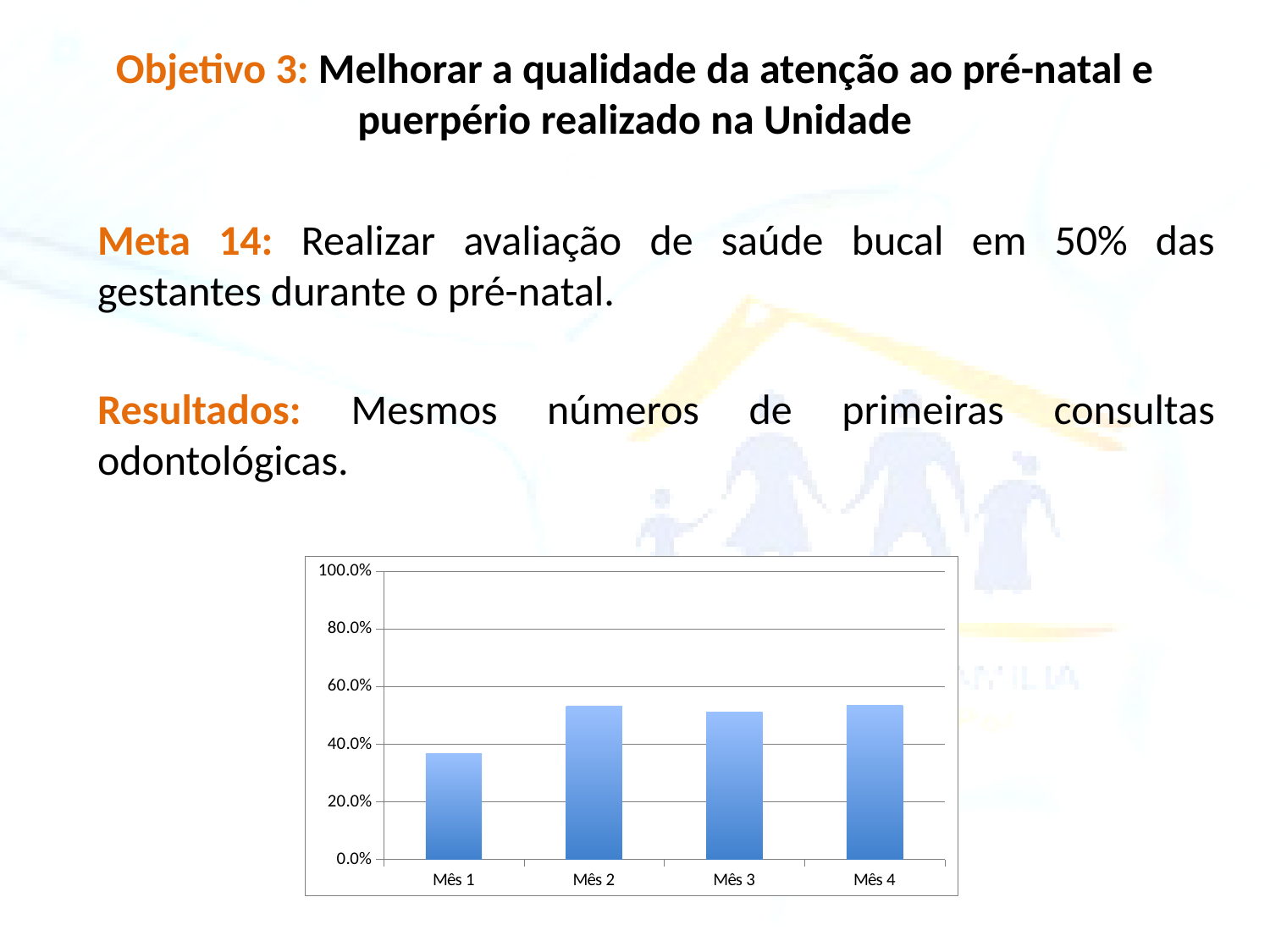
Is the value for Mês 1 greater or less than 20.0%? greater Is the value for Mês 1 greater or less than 40.0%? less Which is larger, the value for Mês 3 or the value for Mês 1? Mês 3 What kind of chart is shown on the slide? bar chart Is the value for Mês 4 greater or less than 60.0%? less Which is larger, the value for Mês 1 or the value for Mês 2? Mês 2 How many categories are shown on the x axis of the chart? 4 Which month has the lowest value in the chart? Mês 1 What is the highest value shown on the y axis of the chart? 100.0%